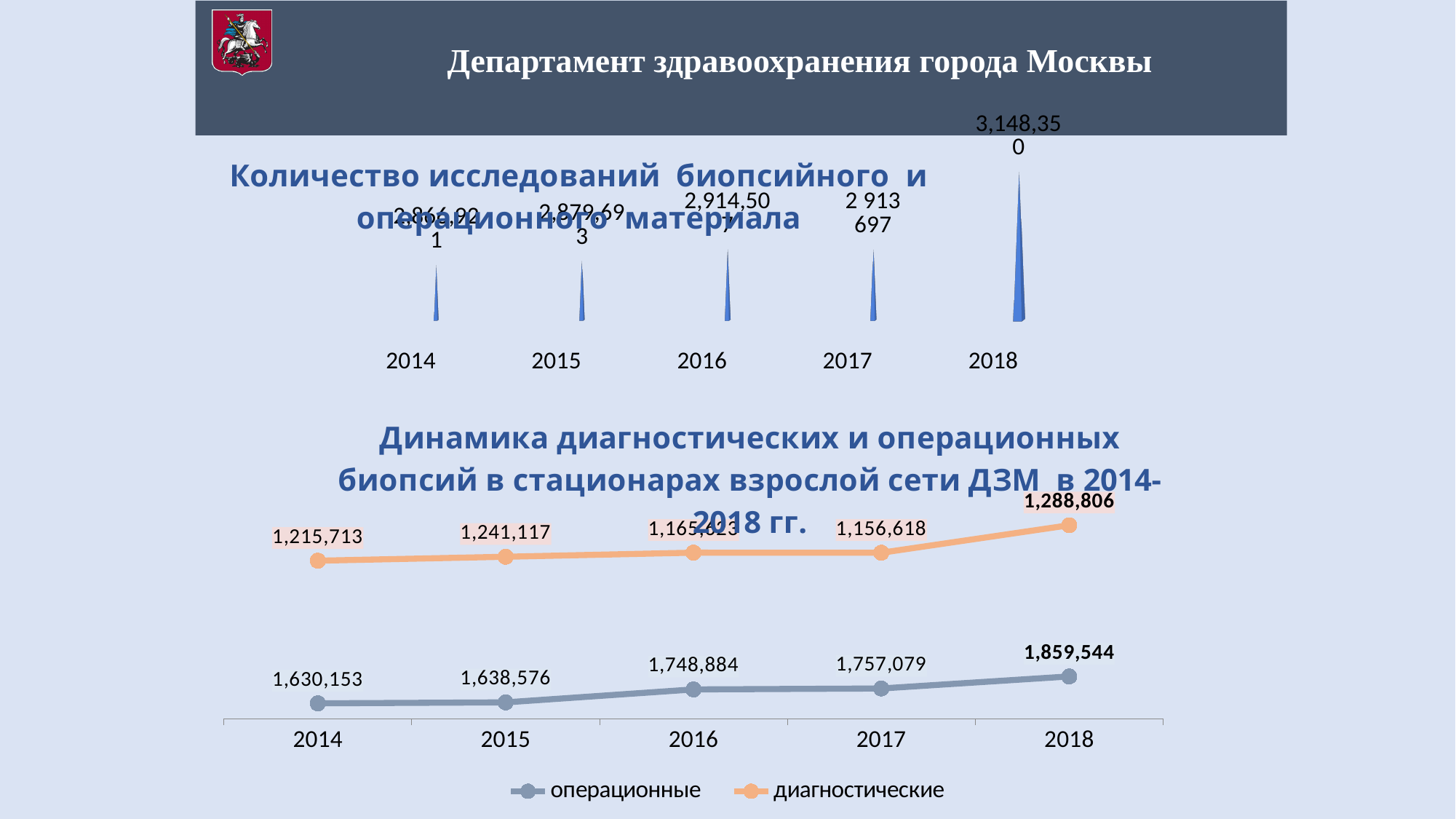
In the bottom chart (Динамика диагностических и операционных биопсий), what is the difference between the операционные values for 2018 and 2014? 229,391 In the top chart (Количество исследований биопсийного и операционного материала), which year has the highest value? 2018 In the bottom chart (Динамика диагностических и операционных биопсий), what is the value for диагностические in 2014? 1,215,713 In the bottom chart (Динамика диагностических и операционных биопсий), what is the value for операционные in 2018? 1,859,544 In the top chart (Количество исследований биопсийного и операционного материала), what is the value for 2017? 2 913 697 What kind of chart is the top chart (Количество исследований биопсийного и операционного материала)? bar chart In the bottom chart (Динамика диагностических и операционных биопсий), which series has the larger value in 2017, операционные or диагностические? операционные In the bottom chart (Динамика диагностических и операционных биопсий), do the операционные values rise or fall from 2014 to 2018? rise In the bottom chart (Динамика диагностических и операционных биопсий), how many series does the legend list? 2 In the top chart (Количество исследований биопсийного и операционного материала), how many years are shown on the x axis? 5 In the top chart (Количество исследований биопсийного и операционного материала), what is the value for 2018? 3,148,350 What kind of chart is the bottom chart (Динамика диагностических и операционных биопсий)? line chart